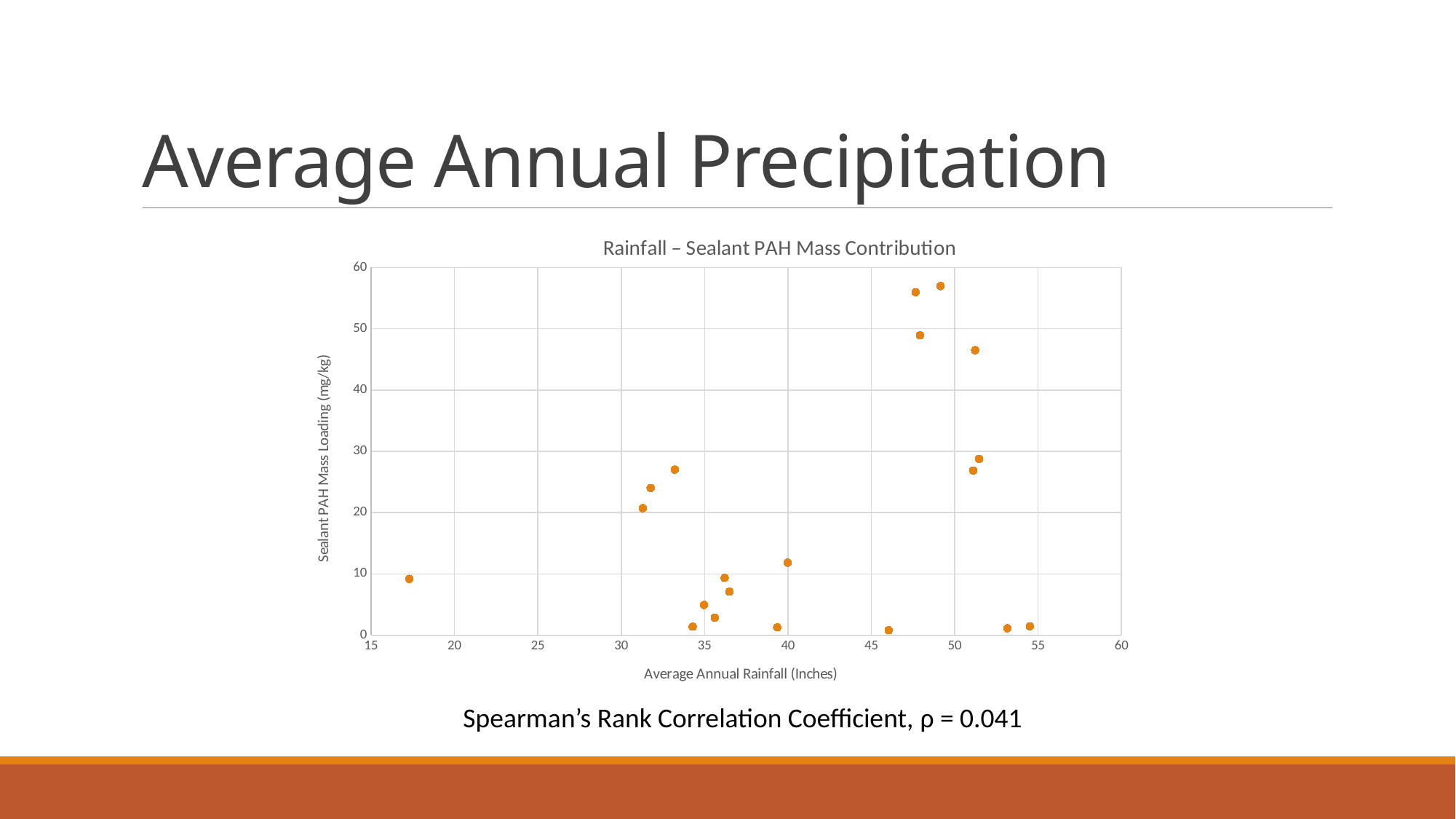
Which is larger: the Sealant PAH Mass Loading of the point at about 49 inches of rainfall or the point at about 54.5 inches of rainfall? the point at about 49 inches What kind of chart is shown on the slide? scatter plot What is the title of the chart? Rainfall – Sealant PAH Mass Contribution Is the Sealant PAH Mass Loading for the point at about 46 inches of rainfall greater or less than 10 mg/kg? less How many data points are plotted on the chart? 20 What is the label of the y axis of the chart? Sealant PAH Mass Loading (mg/kg) Does Sealant PAH Mass Loading show a clear rising or falling trend as Average Annual Rainfall increases? no clear trend Is the Sealant PAH Mass Loading for the point at about 33 inches of rainfall greater or less than 20 mg/kg? greater Is the highest plotted Sealant PAH Mass Loading value greater or less than 50 mg/kg? greater What is the maximum value shown on the x axis (Average Annual Rainfall)? 60